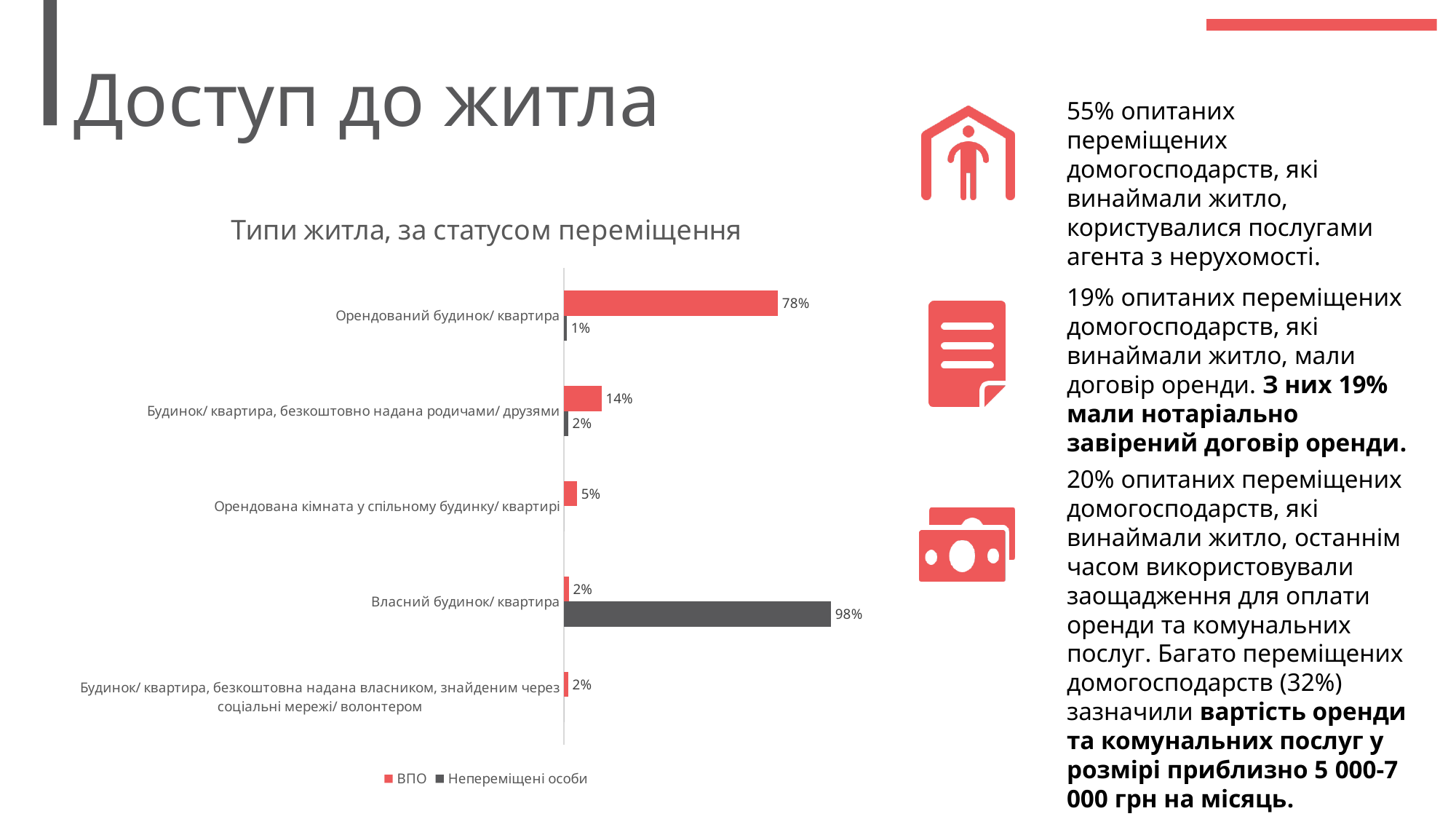
Which category has the highest value for ВПО? Орендований будинок/ квартира What is the difference between the ВПО value and the Непереміщені особи value for 'Орендований будинок/ квартира'? 77% What is the value for ВПО in the category 'Будинок/ квартира, безкоштовно надана родичами/ друзями'? 14% How many series does the chart legend list? 2 For 'Власний будинок/ квартира', which series has the larger value, ВПО or Непереміщені особи? Непереміщені особи What is the value for Непереміщені особи in the category 'Власний будинок/ квартира'? 98% What is the title of the chart? Типи житла, за статусом переміщення How many housing-type categories are shown on the chart? 5 What is the value for ВПО in the category 'Орендована кімната у спільному будинку/ квартирі'? 5% What is the value for ВПО in the category 'Орендований будинок/ квартира'? 78% What type of chart is shown on the slide? bar chart Which category has the highest value for Непереміщені особи? Власний будинок/ квартира